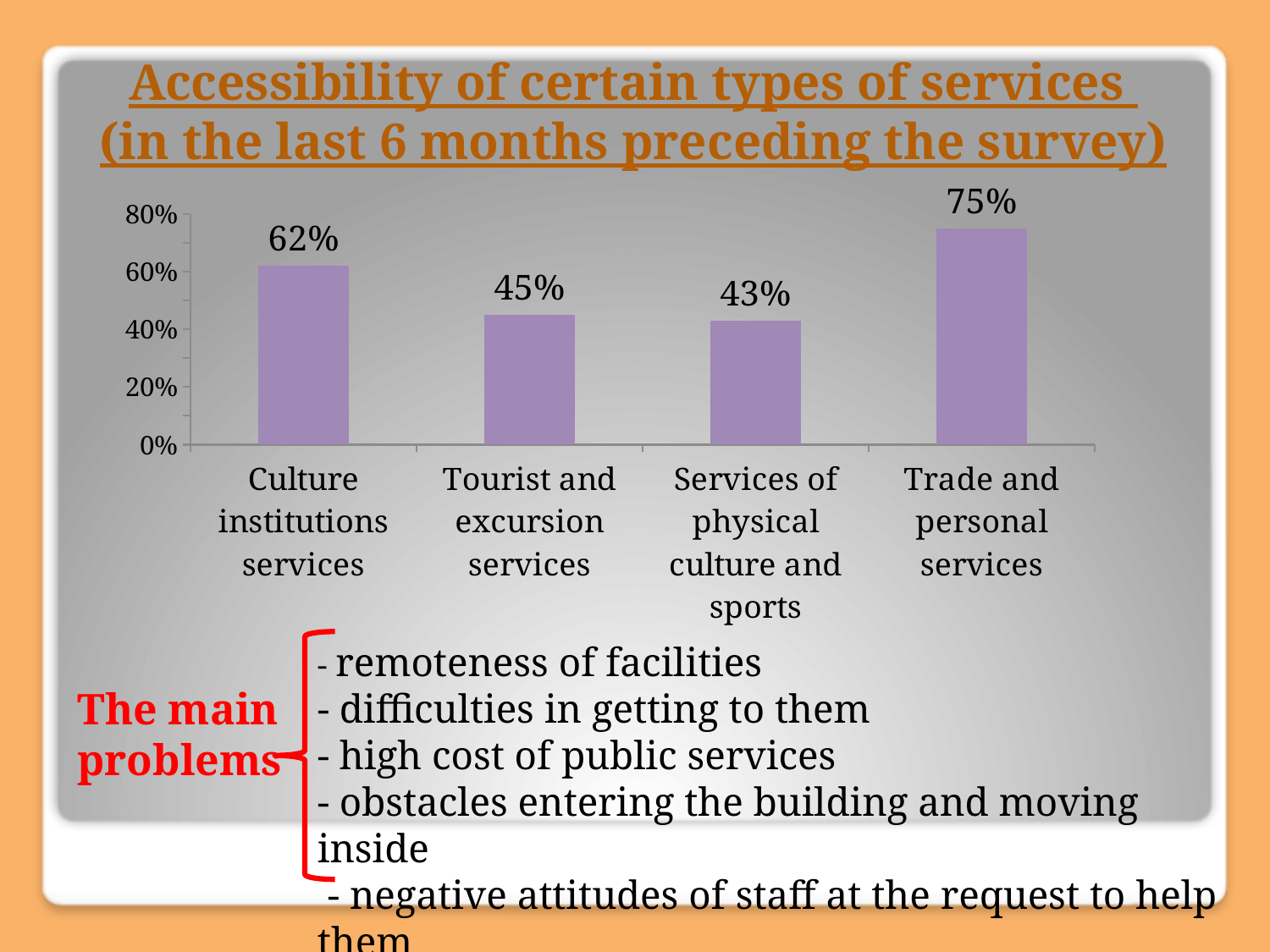
What kind of chart is shown on the slide? bar chart What is the value for Services of physical culture and sports? 43% What is the difference between the values for Trade and personal services and Culture institutions services? 13% Which is larger: the value for Culture institutions services or the value for Tourist and excursion services? Culture institutions services What is the value for Tourist and excursion services? 45% Which category has the highest value? Trade and personal services What is the value for Trade and personal services? 75% Which category has the lowest value? Services of physical culture and sports What is the title of the chart? Accessibility of certain types of services (in the last 6 months preceding the survey) Is the value for Trade and personal services greater or less than 60%? greater What is the value for Culture institutions services? 62% How many categories are shown in the chart? 4